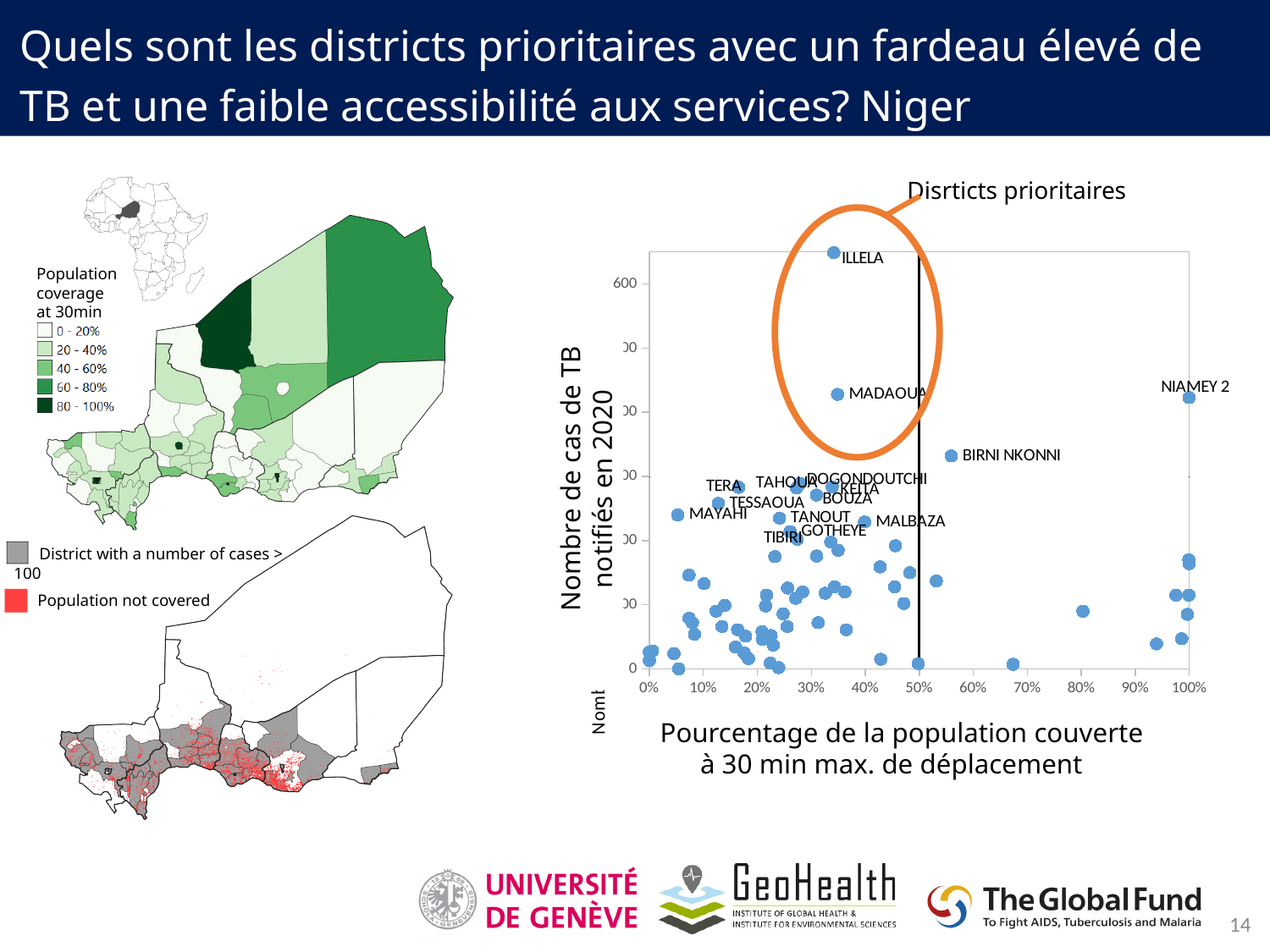
In the scatter chart, is the number of TB cases for ILLELA greater or less than 600? greater In the scatter chart, is the population coverage percentage for ILLELA greater or less than 50%? less What is the x-axis title of the scatter chart? Pourcentage de la population couverte à 30 min max. de déplacement In the scatter chart, which labeled district has the highest number of TB cases notified in 2020? ILLELA In the scatter chart, which has more notified TB cases, ILLELA or MADAOUA? ILLELA In the scatter chart, at what x-axis value is the vertical black line drawn? 50% In the scatter chart, is the population coverage percentage for MAYAHI greater or less than 10%? less What kind of chart is shown on the right side of the slide? scatter chart In the scatter chart, which has more notified TB cases, NIAMEY 2 or BIRNI NKONNI? NIAMEY 2 In the scatter chart, how many districts are enclosed by the orange circle labeled 'Disrticts prioritaires'? 2